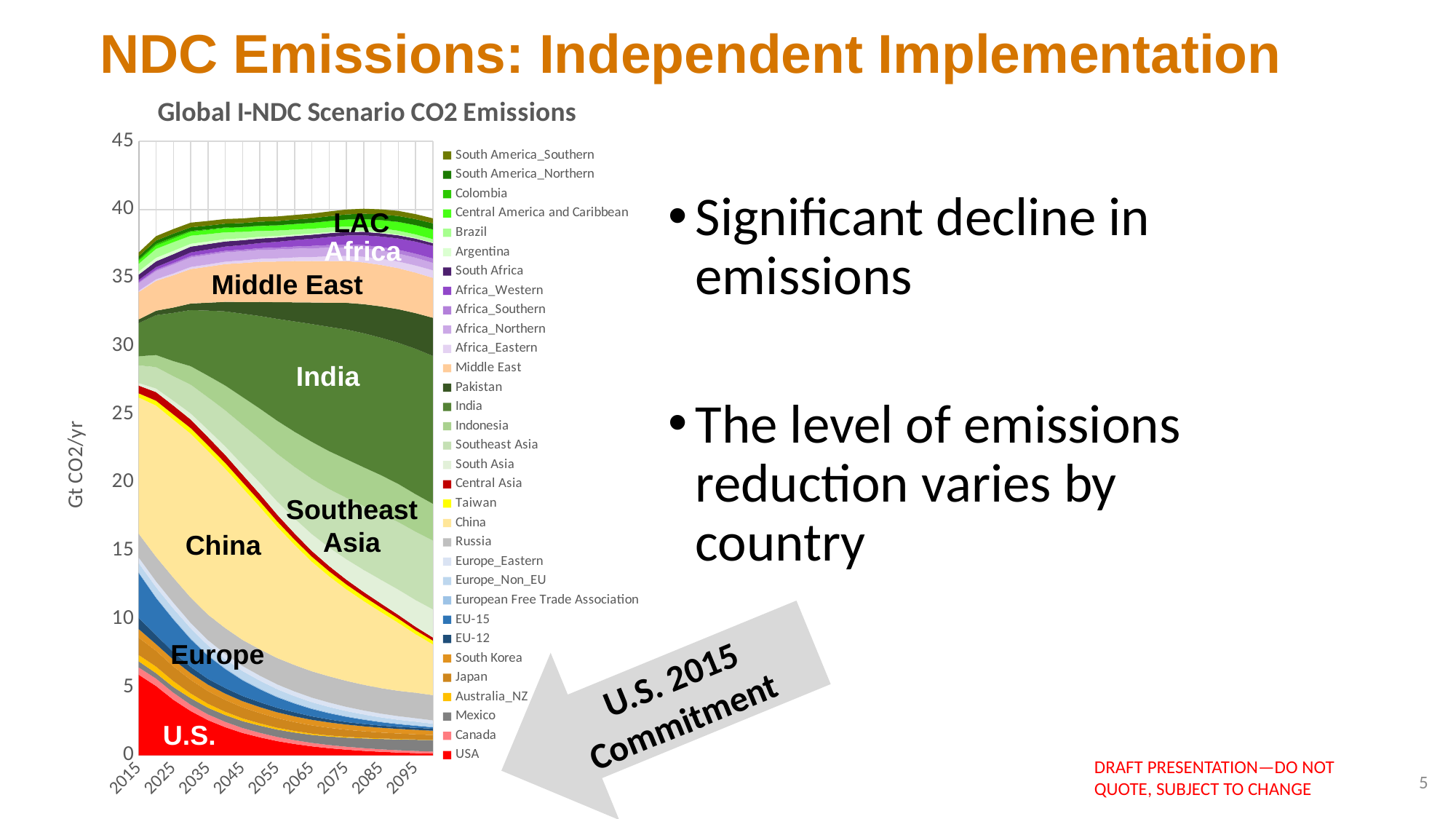
What is the label on the vertical axis of the chart? Gt CO2/yr What is the last year shown on the x axis of the chart? 2095 What is the title of the chart? Global I-NDC Scenario CO2 Emissions Do China's emissions rise or fall from 2015 to 2095? fall Do India's emissions rise or fall from 2015 to 2095? rise Is the U.S. emissions value in 2015 greater or less than 10 Gt CO2/yr? less What kind of chart is shown on the slide? Stacked area chart What is the first year shown on the x axis of the chart? 2015 How many year labels are shown along the x axis of the chart? 9 Is the total global emissions value in 2015 greater or less than 35 Gt CO2/yr? greater How many series does the chart's legend list? 32 Do the U.S. emissions rise or fall from 2015 to 2095? fall